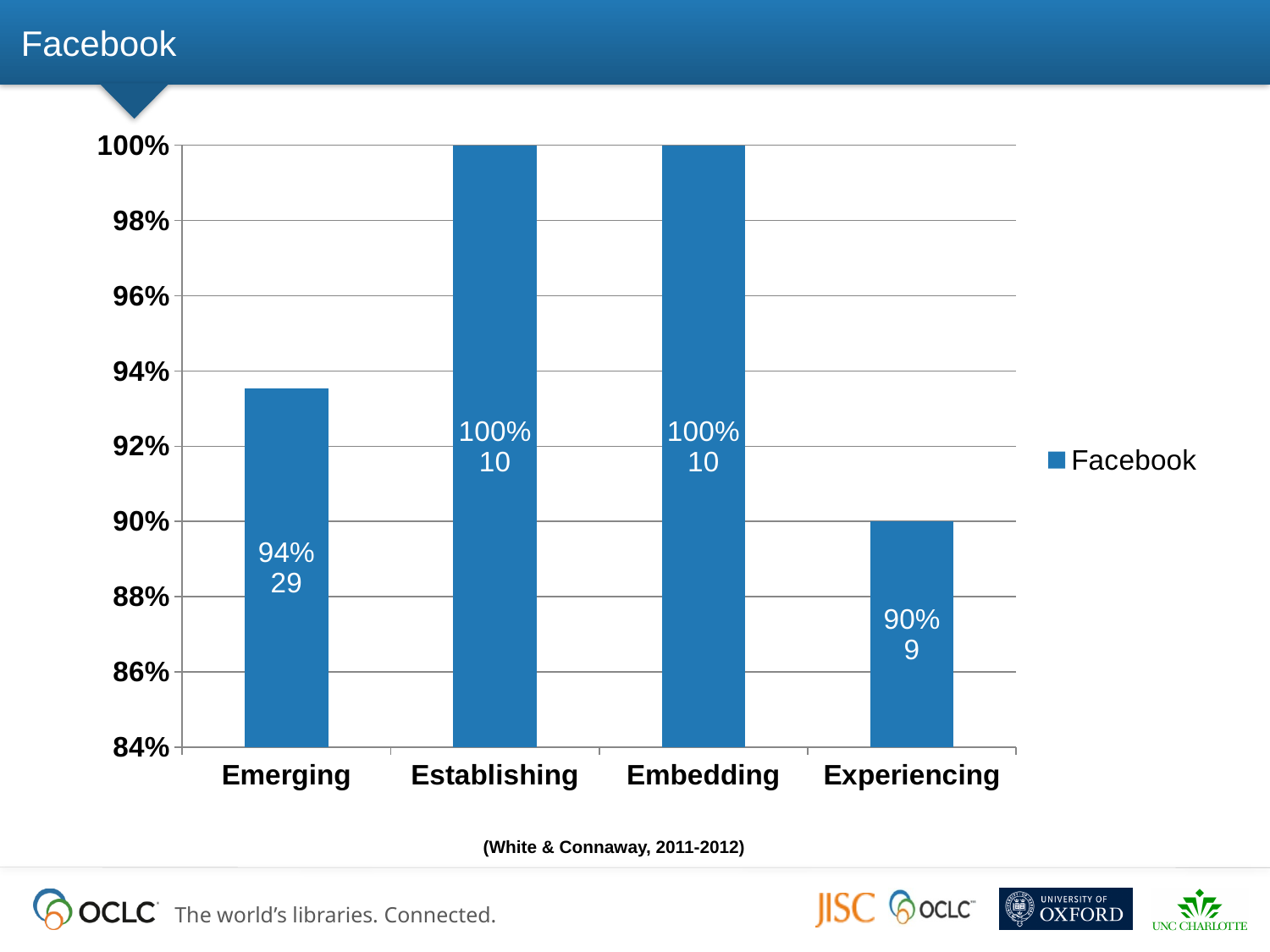
What kind of chart is shown on the slide? Bar chart Is the value for Emerging greater or less than 92%? greater What percentage is shown for the Experiencing category? 90% Which category has the lowest percentage? Experiencing What count is printed on the Embedding bar below its percentage? 10 Which is larger, the percentage for Emerging or the percentage for Experiencing? Emerging What is the difference in percentage points between Establishing and Experiencing? 10% What percentage is shown for the Emerging category? 94% How many series does the legend list? 1 How many categories are shown on the x axis? 4 What is the name of the series shown in the legend? Facebook What count is printed on the Emerging bar below its percentage? 29